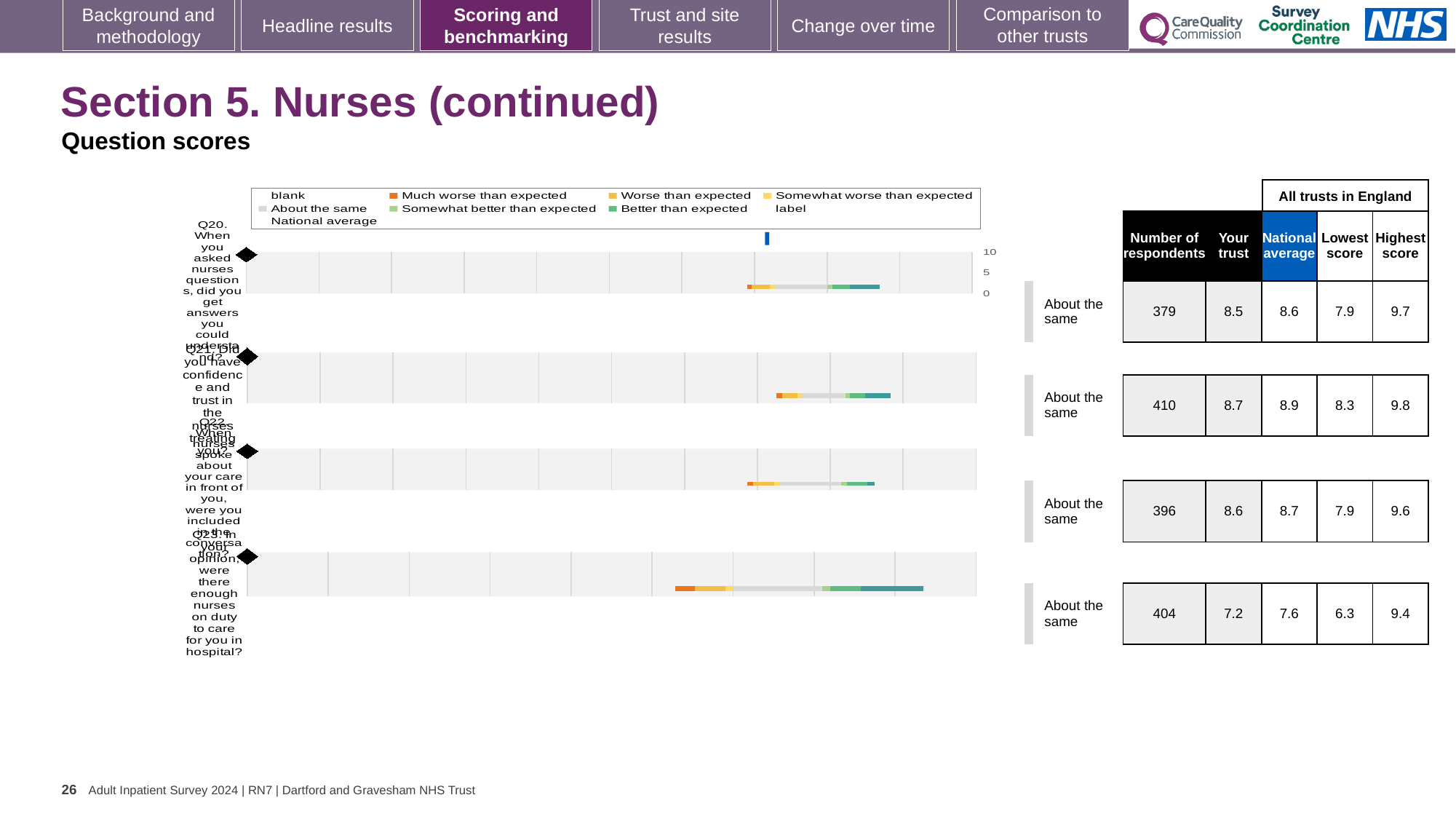
Which question has the highest 'Your trust' score? Q21 What is the highest score among all trusts in England for Q21? 9.8 What colour does the legend use for 'Much worse than expected'? Orange For Q23, what is the difference between the national average and the 'Your trust' score? 0.4 For Q20, which is larger: the 'Your trust' score or the national average? National average What is the 'Your trust' score for Q23 (were there enough nurses on duty)? 7.2 Which question has the lowest 'Your trust' score? Q23 What benchmark category is shown for Q22 (nurses speaking about your care in front of you)? About the same What kind of chart is used to show the question scores for Q20 to Q23? bar chart What is the lowest score among all trusts in England for Q23? 6.3 How many respondents are listed for Q21 (confidence and trust in nurses)? 410 How many questions (rows) are plotted in the chart? 4